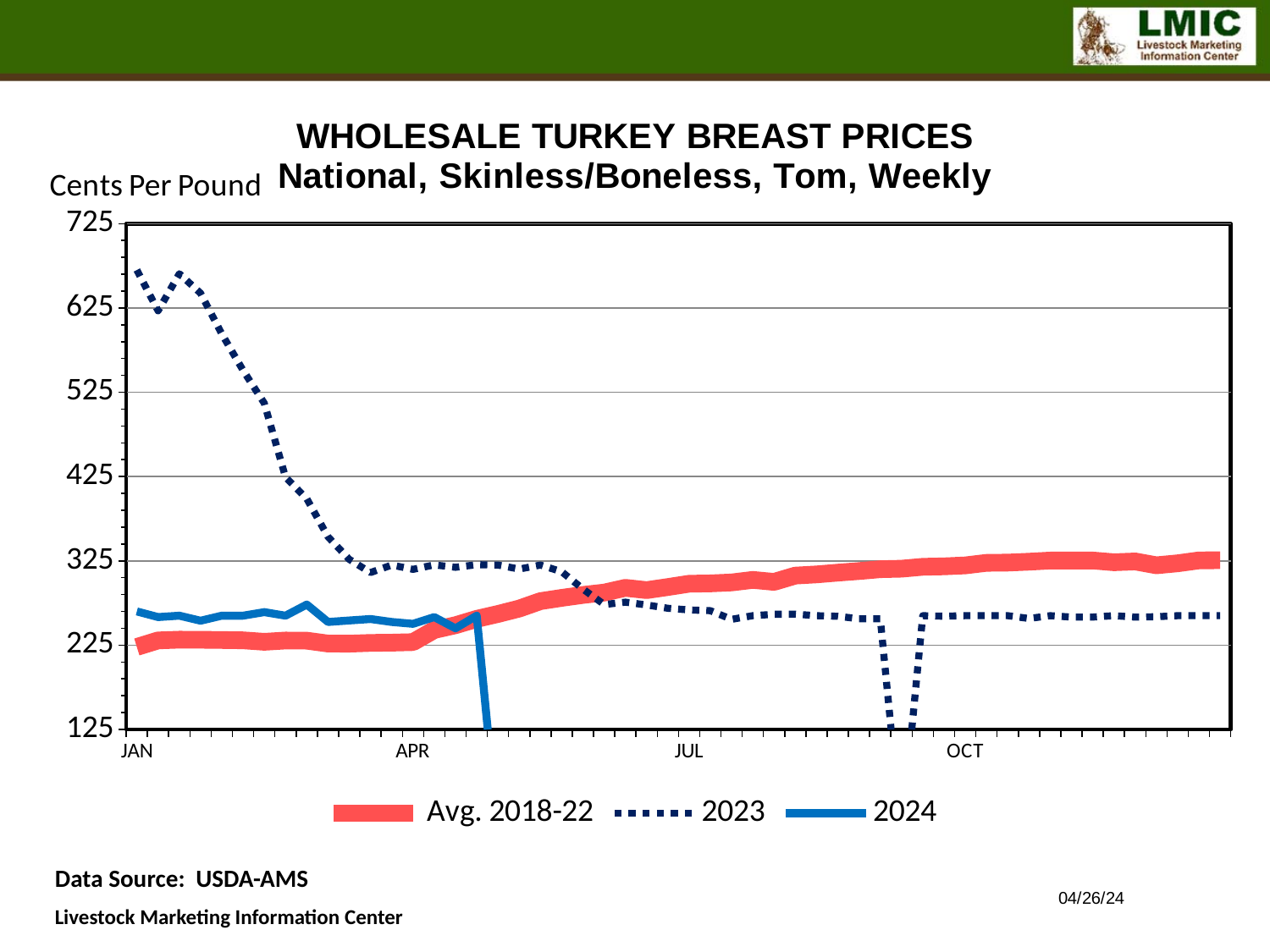
How many series does the legend list? 3 Is the 2023 value at the start of January greater or less than 525? greater Is the Avg. 2018-22 value in January greater or less than 325? less What are the three series named in the legend? Avg. 2018-22, 2023, 2024 What unit is shown on the vertical axis label? Cents Per Pound In January, which series is higher, 2023 or 2024? 2023 Does the 2023 series rise or fall from January to April? fall What kind of chart is shown on the slide? line chart Does the Avg. 2018-22 series rise or fall from January to October? rise Is the 2024 value in January greater or less than 225? greater Which series reaches the highest value shown on the chart? 2023